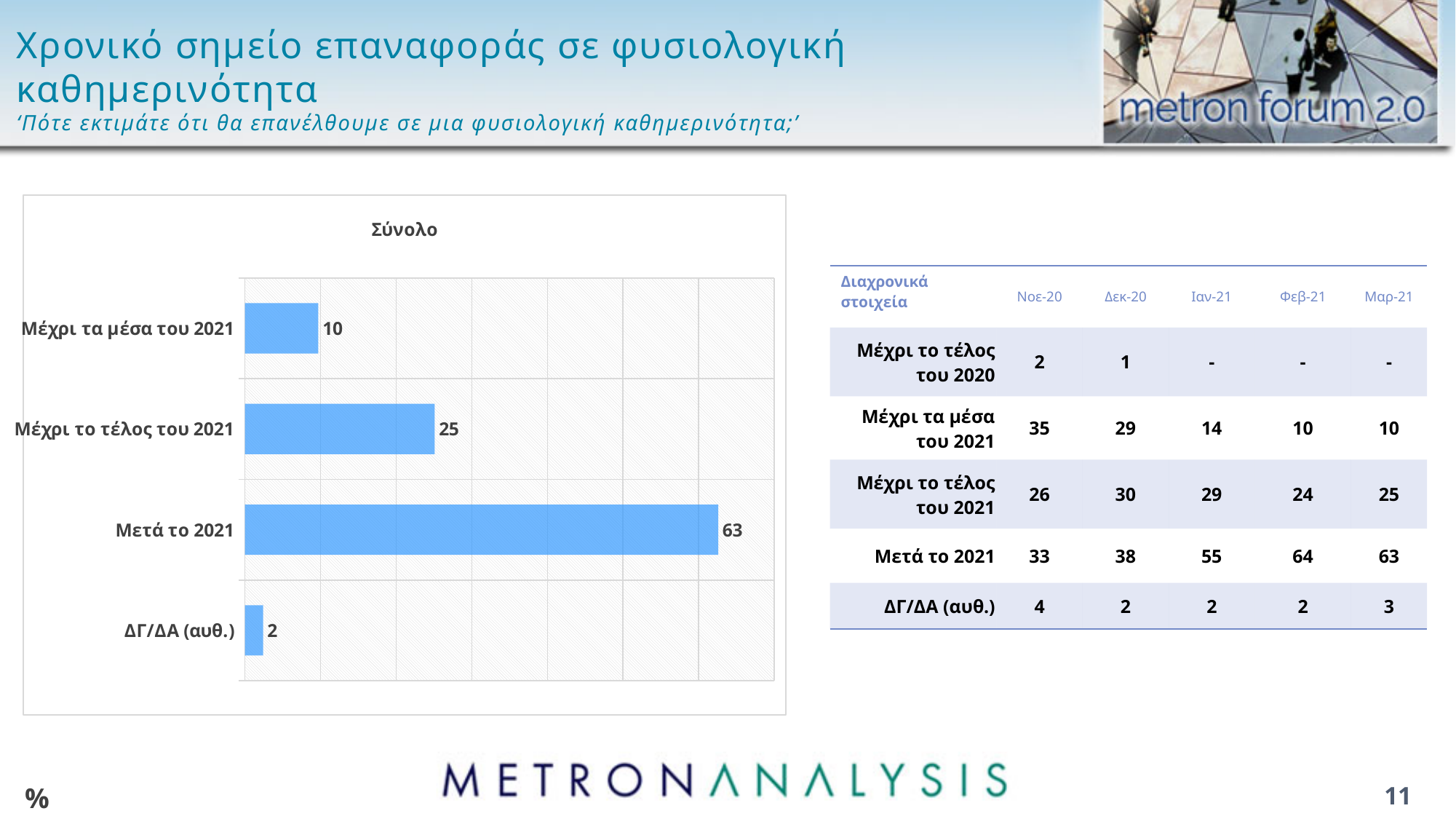
Which category has the highest value in the chart? Μετά το 2021 Which category has the lowest value in the chart? ΔΓ/ΔΑ (αυθ.) Which is larger: the value for 'Μέχρι τα μέσα του 2021' or the value for 'Μέχρι το τέλος του 2021'? Μέχρι το τέλος του 2021 What is the title of the chart? Σύνολο What is the value for 'Μέχρι το τέλος του 2021' in the chart? 25 How many categories are shown in the chart? 4 What is the value for 'ΔΓ/ΔΑ (αυθ.)' in the chart? 2 What is the difference between the values for 'Μέχρι το τέλος του 2021' and 'Μέχρι τα μέσα του 2021'? 15 What is the value for 'Μέχρι τα μέσα του 2021' in the chart? 10 What is the difference between the values for 'Μετά το 2021' and 'Μέχρι το τέλος του 2021'? 38 What is the value for 'Μετά το 2021' in the chart? 63 What kind of chart is shown on the slide? Bar chart